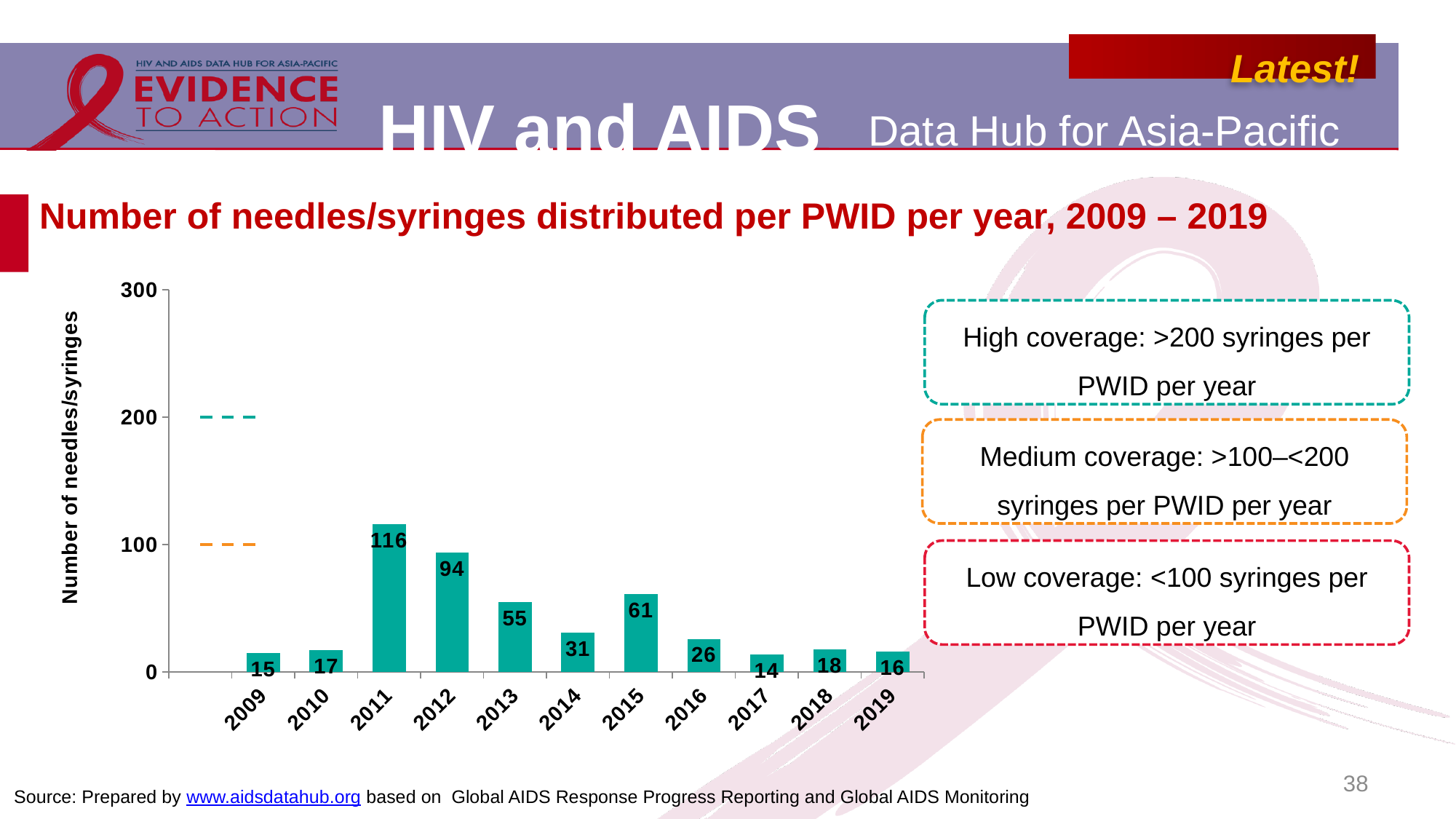
What is the difference between the values for 2011 and 2012? 22 What is the value shown for 2019? 16 What is the difference between the values for 2015 and 2016? 35 What is the number of needles/syringes distributed per PWID in 2011? 116 What is the label of the y axis of the chart? Number of needles/syringes What is the value shown for 2015? 61 How many years are shown on the x axis of the chart? 11 Which year has the highest number of needles/syringes distributed per PWID? 2011 What kind of chart is shown on the slide? bar chart Which year has a larger value, 2013 or 2014? 2013 Is the value for 2011 greater or less than 100? greater Which year has the lowest number of needles/syringes distributed per PWID? 2017